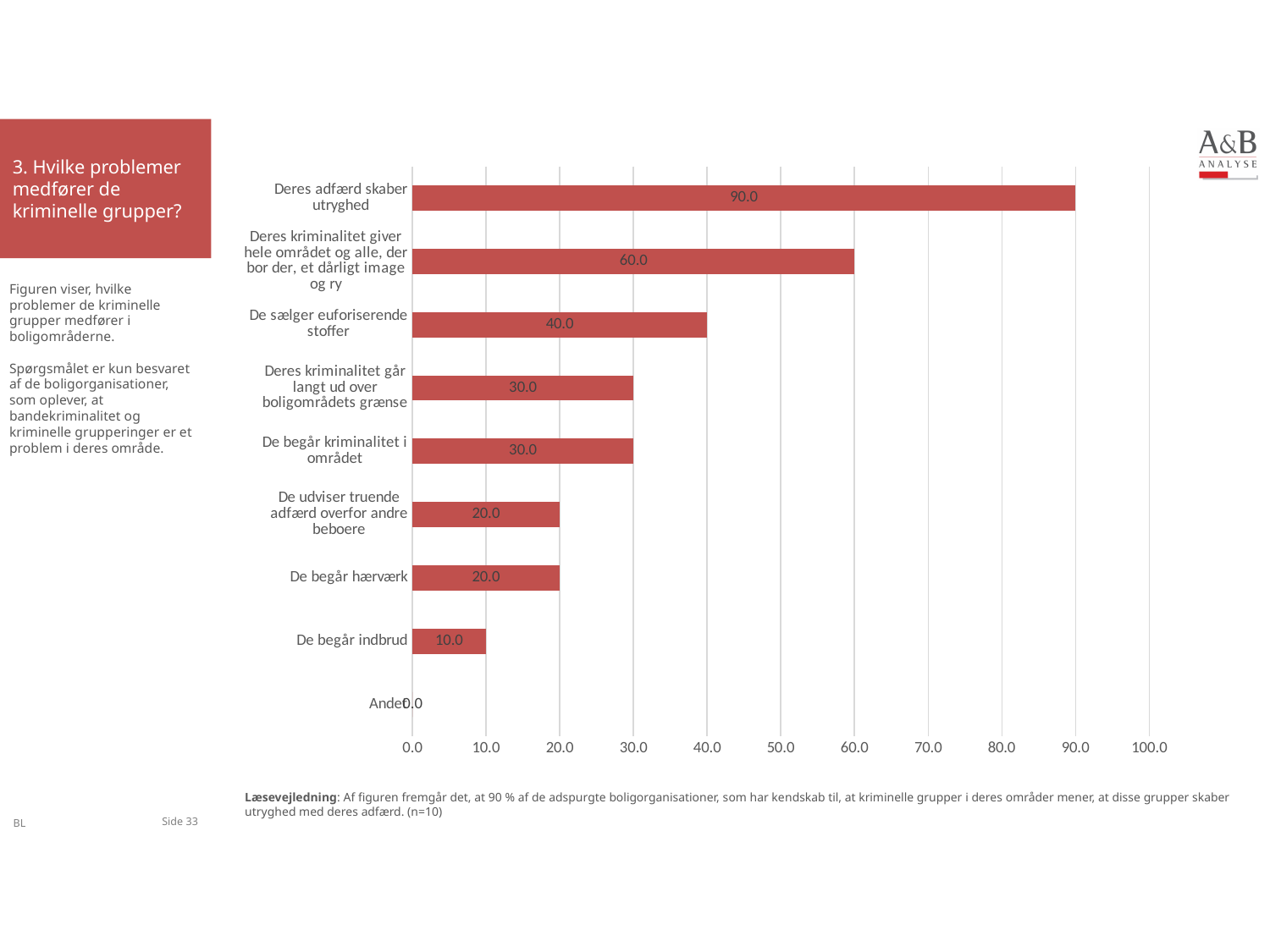
What is the value for "De sælger euforiserende stoffer"? 40.0 What is the difference between the values for "Deres adfærd skaber utryghed" and "Deres kriminalitet giver hele området og alle, der bor der, et dårligt image og ry"? 30.0 What is the value for "De begår indbrud"? 10.0 What is the value for "Deres adfærd skaber utryghed"? 90.0 Which is larger: the value for "De sælger euforiserende stoffer" or the value for "De begår hærværk"? De sælger euforiserende stoffer Which category has the highest value? Deres adfærd skaber utryghed Which category has the lowest value? Andet How many categories are shown in the chart? 9 What is the value for "Andet"? 0.0 What is the value for "De udviser truende adfærd overfor andre beboere"? 20.0 Is the value for "Deres kriminalitet giver hele området og alle, der bor der, et dårligt image og ry" greater or less than 50.0? greater What kind of chart is shown on the slide? Bar chart